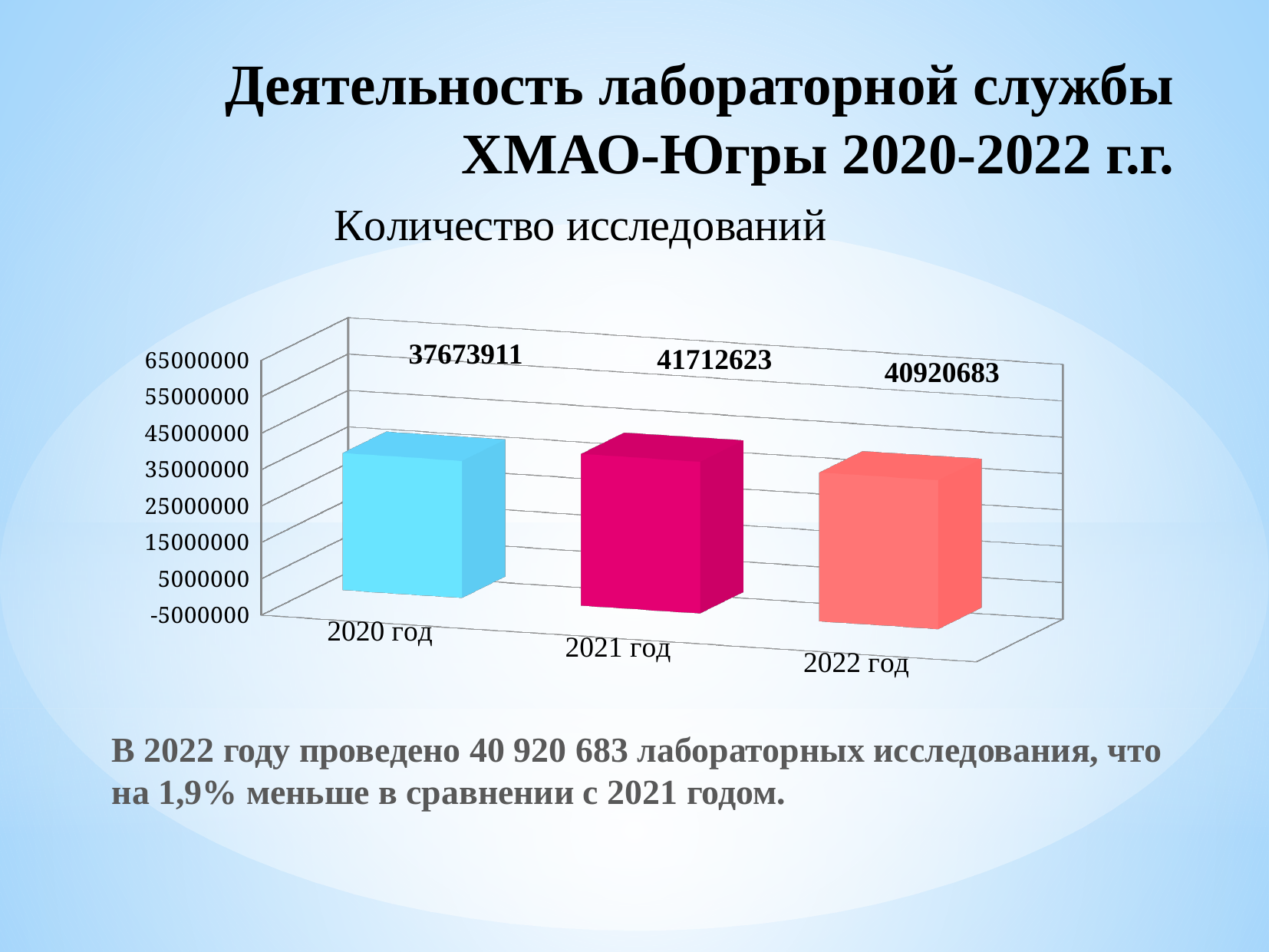
What is the number of studies shown for 2022 год? 40920683 Which year has the lowest number of studies? 2020 год Which is larger, the value for 2020 год or the value for 2022 год? 2022 год What is the difference between the values for 2021 год and 2022 год? 791940 What is the number of studies shown for 2021 год? 41712623 What kind of chart is shown on the slide? bar chart What is the difference between the values for 2021 год and 2020 год? 4038712 Is the value for 2020 год greater or less than 45000000? less Which year has the highest number of studies? 2021 год What is the title of the chart? Количество исследований How many years are shown on the chart? 3 What is the number of studies shown for 2020 год? 37673911